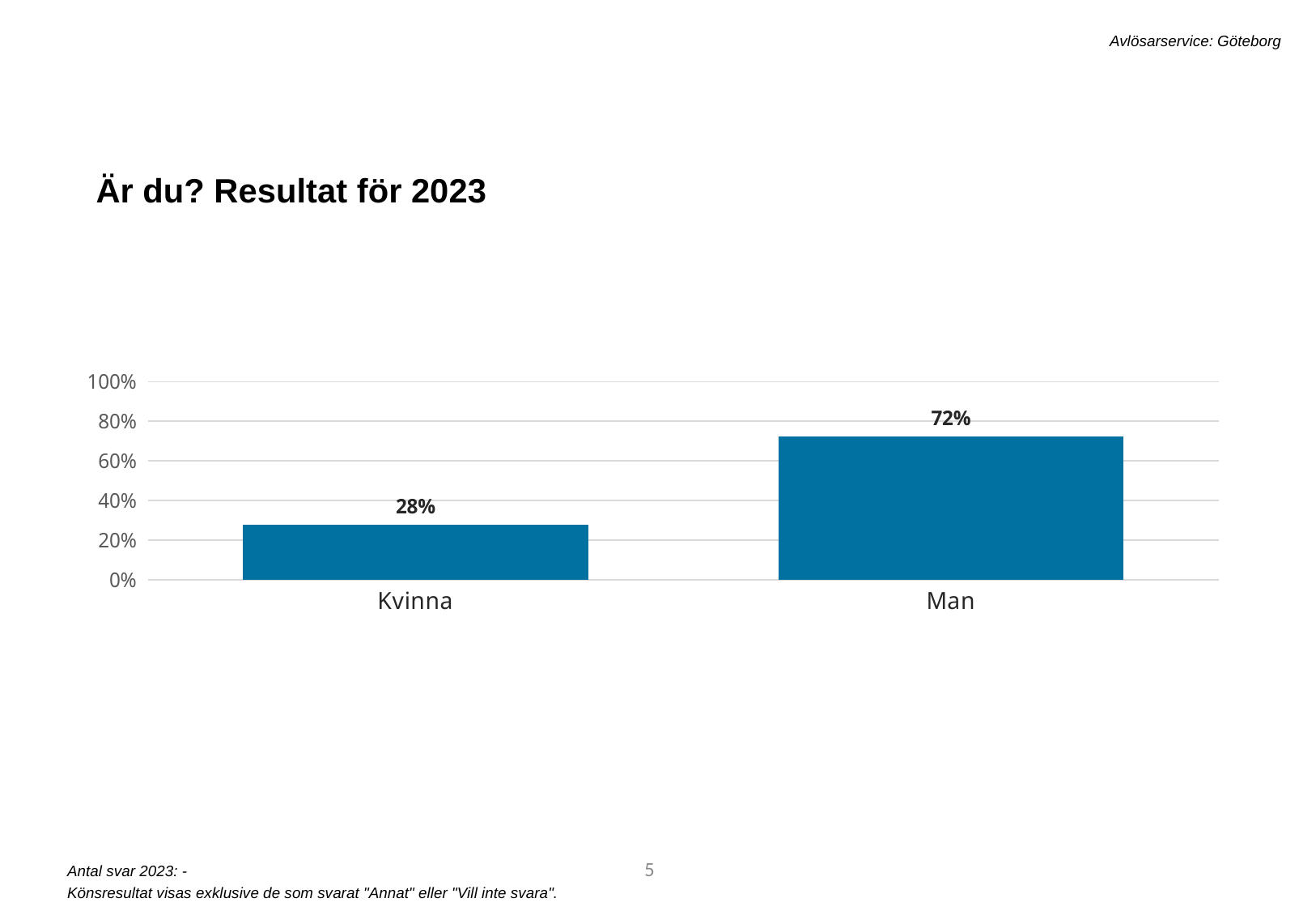
What is the value for Kvinna? 28% Is the value for Kvinna greater or less than 40%? less Which is larger, the value for Kvinna or the value for Man? Man What is the value for Man? 72% Which category has the lowest value? Kvinna What kind of chart is shown on the slide? bar chart What is the title of the slide? Är du? Resultat för 2023 How many categories are shown on the x axis? 2 What is the difference between the values for Man and Kvinna? 44% Which category has the highest value? Man Is the value for Man greater or less than 60%? greater What is the highest value shown on the y axis? 100%